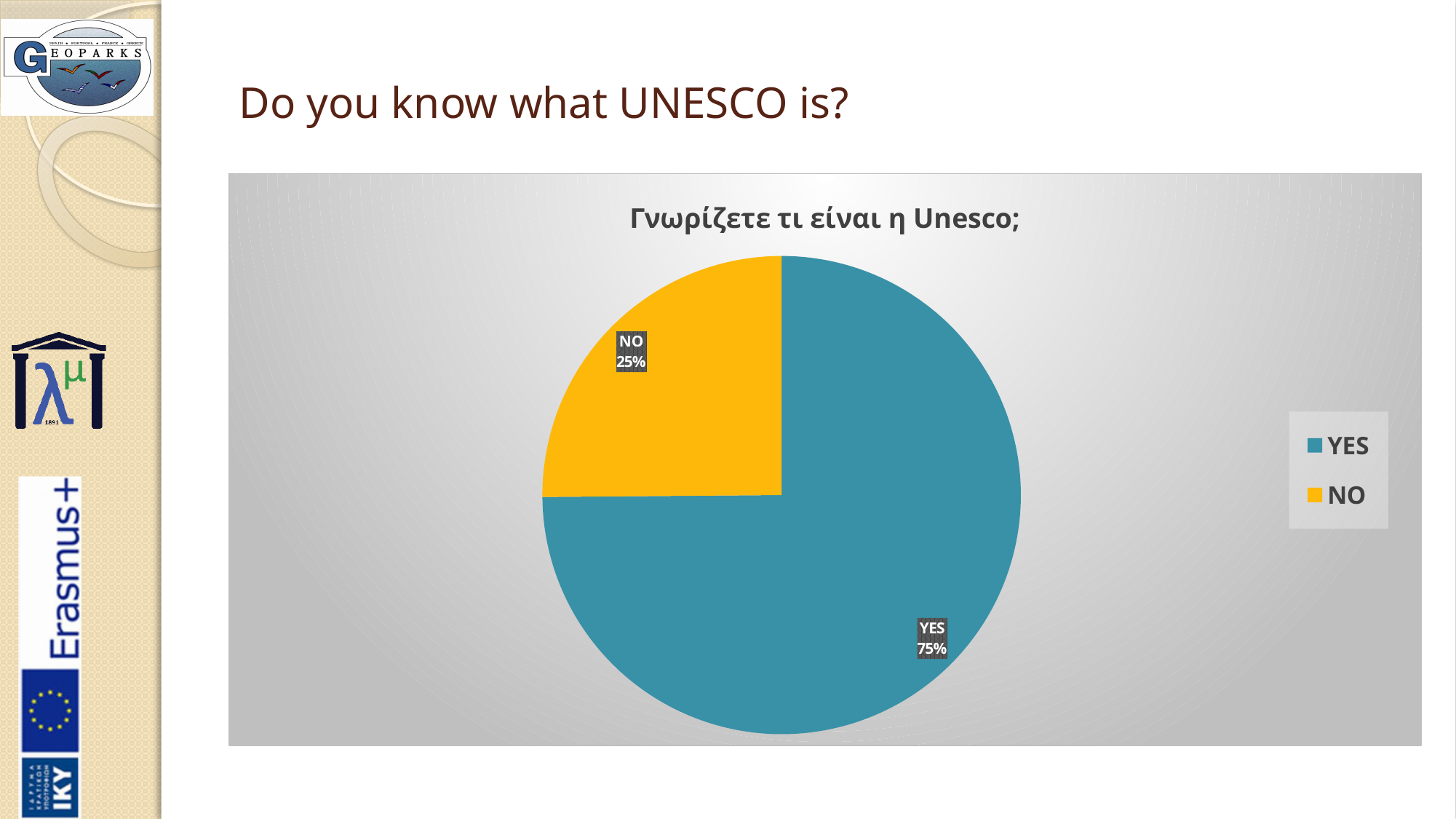
What percentage of respondents answered NO? 25% What share of the pie does the NO slice represent? 25% What colour is the YES slice? teal blue What is the title shown above the pie chart? Γνωρίζετε τι είναι η Unesco; What is the difference in percentage points between the YES and NO slices? 50 How many entries does the legend list? 2 Which response has the largest share of the pie? YES What kind of chart is shown on the slide? pie chart Which response has the smallest share of the pie? NO What percentage of respondents answered YES? 75% Which slice is larger, YES or NO? YES How many slices does the pie chart have? 2